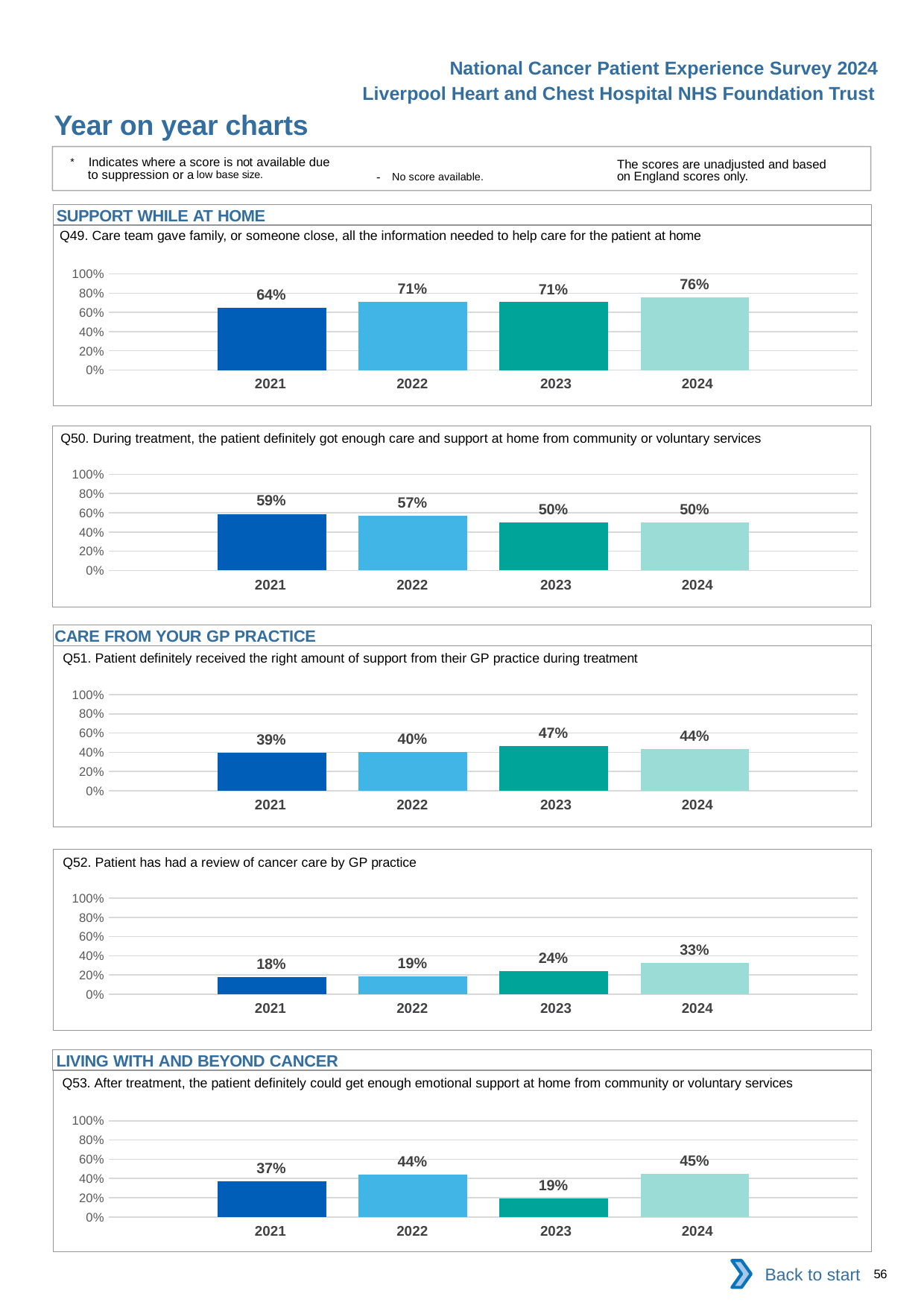
What kind of chart is the Q49 chart? bar chart How many charts are shown on the slide? 5 In the Q50 chart, which year has the highest value? 2021 In the Q53 chart, which is larger, the value for 2022 or the value for 2023? 2022 In the Q52 chart, do the values rise or fall from 2021 to 2024? rise In the Q50 chart, what is the difference between the 2021 and 2024 values? 9% In the Q51 chart, what is the difference between the 2023 and 2021 values? 8% How many years are shown on the x axis of the Q50 chart? 4 In the Q53 chart, what is the value for 2023? 19% In the Q49 chart, what is the value for 2024? 76% In the Q52 chart, which year has the lowest value? 2021 In the Q51 chart, is the value for 2023 greater or less than 40%? greater